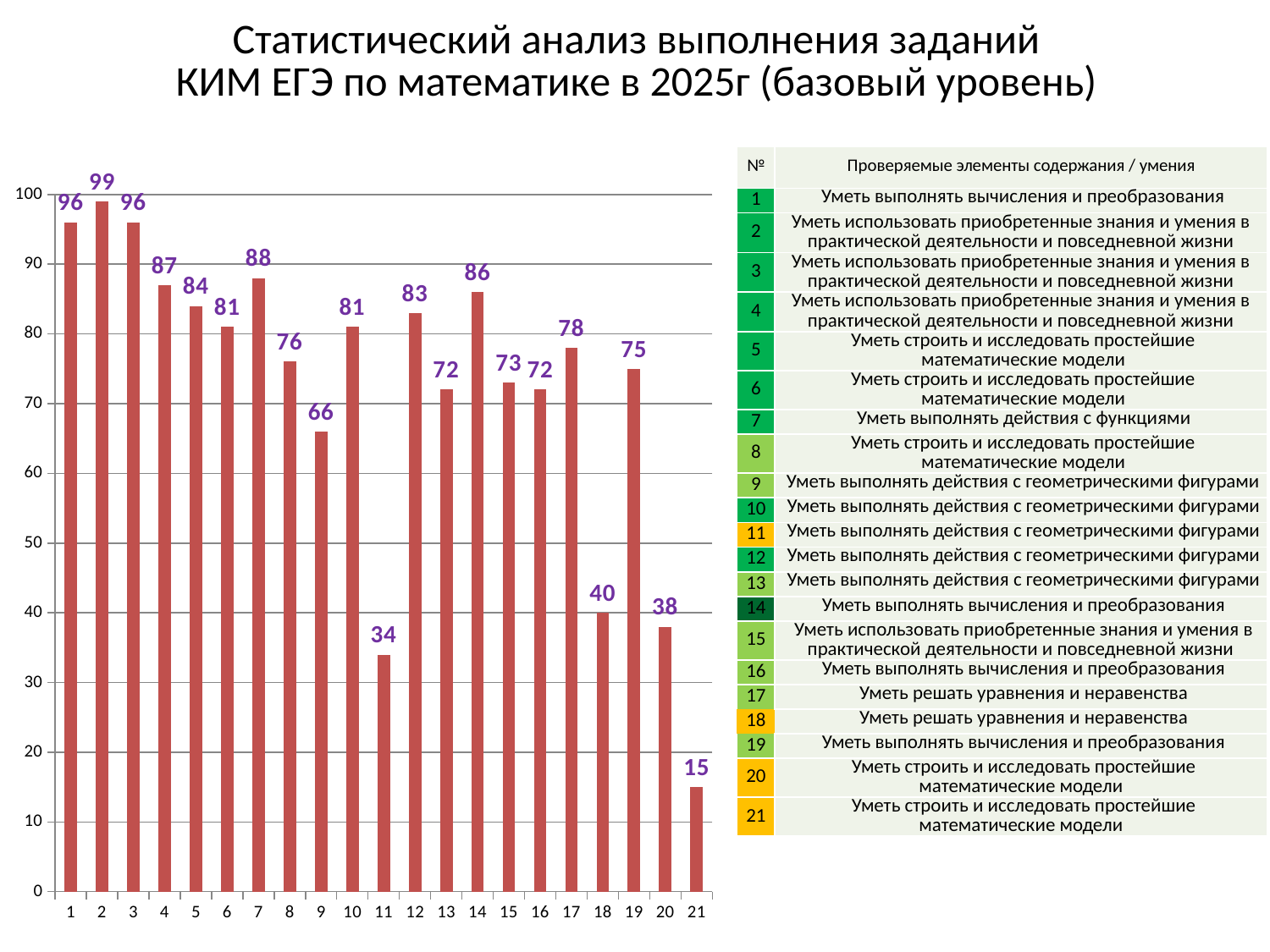
What is the value for task 11? 34 Which is larger, the value for task 18 or the value for task 20? task 18 Which task has the highest value? 2 What is the difference between the values for task 7 and task 8? 12 What is the value for task 2? 99 How many tasks are shown on the x axis? 21 What is the difference between the values for task 1 and task 21? 81 What colour are the bars in the chart? red Is the value for task 9 greater or less than 70? less What kind of chart is shown on the slide? bar chart What is the value for task 14? 86 Which task has the lowest value? 21